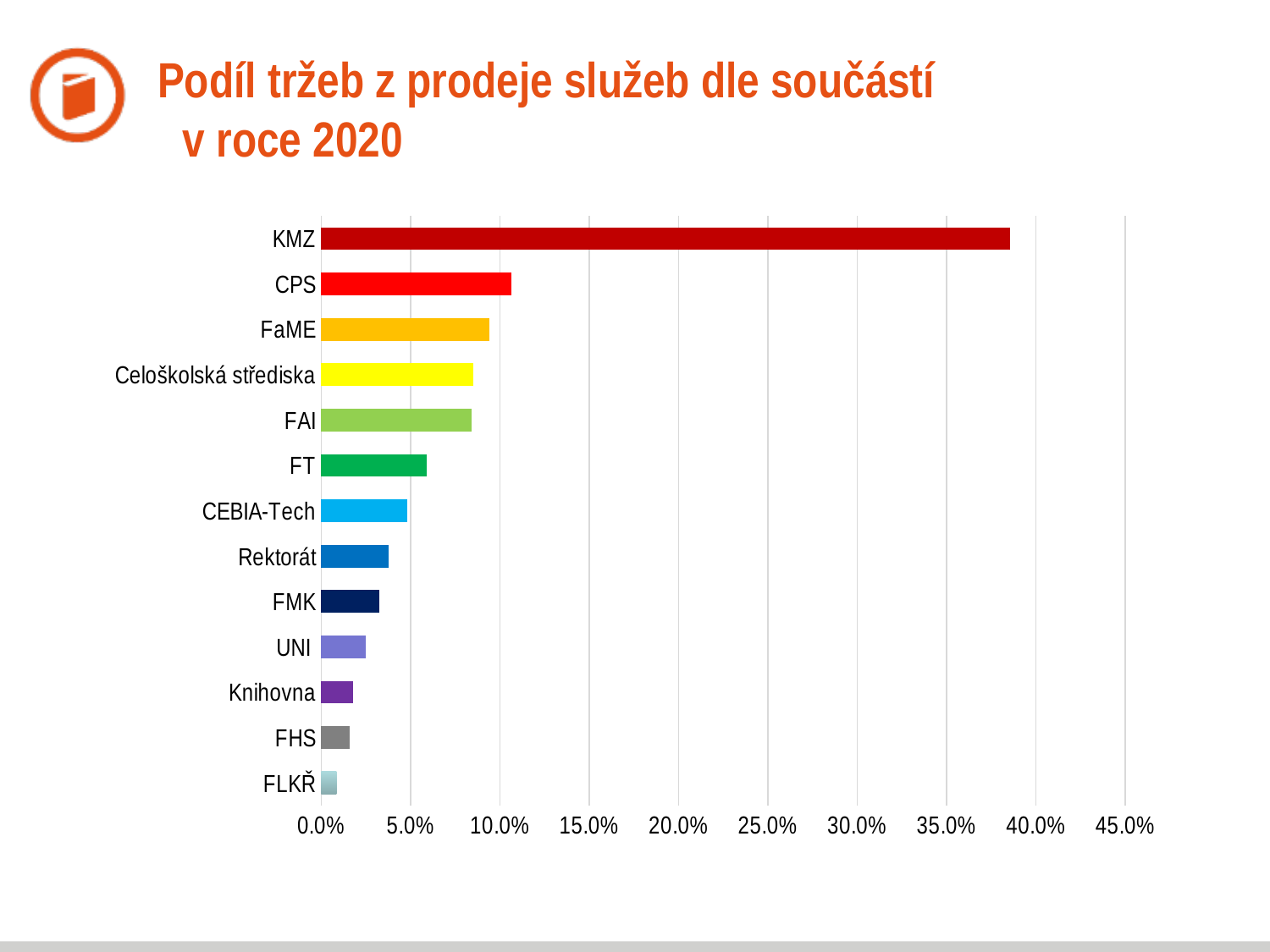
Is the value for FT greater or less than 5.0%? greater Is the value for KMZ greater or less than 35.0%? greater What kind of chart is shown on the slide? bar chart Which category has the lowest share of revenue in the chart? FLKŘ What is the title of the slide containing the chart? Podíl tržeb z prodeje služeb dle součástí v roce 2020 Which has a larger value, UNI or Rektorát? Rektorát Which has a larger value, CPS or FaME? CPS How many categories are plotted in the chart? 13 Which category has the highest share of revenue in the chart? KMZ Which has a larger value, FT or CEBIA-Tech? FT Is the value for FaME greater or less than 10.0%? less